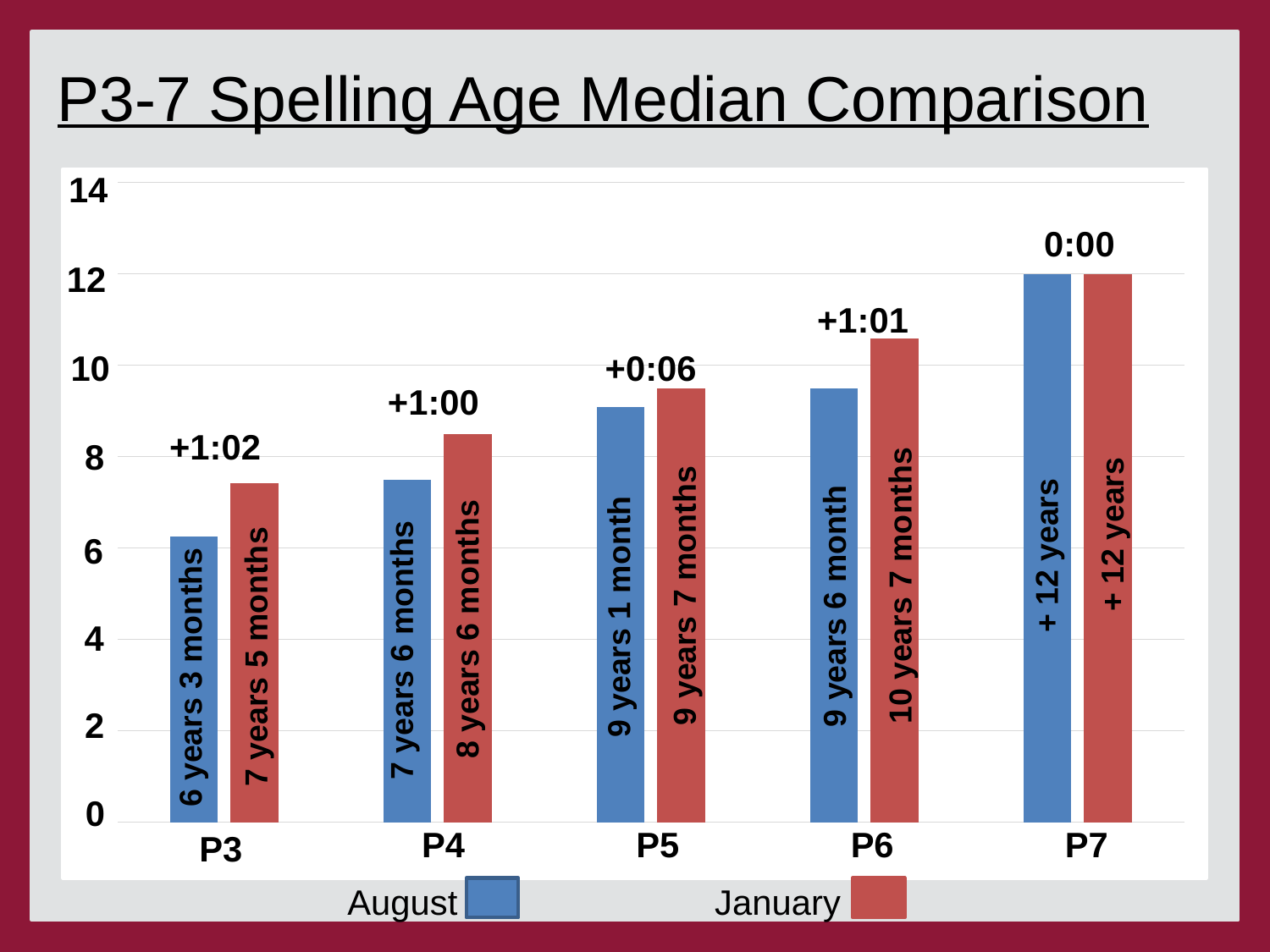
What is the August median spelling age for P3? 6 years 3 months Which year group has the lowest August median spelling age? P3 How many year-group categories are shown on the x axis? 5 Do the August median spelling ages rise or fall from P3 to P7? rise What kind of chart is shown on the slide? bar chart How many series does the legend list? 2 What change is printed above the P6 bars? +1:01 What is the January median spelling age for P6? 10 years 7 months What is the January median spelling age for P4? 8 years 6 months Is the January value for P6 greater or less than 10? greater What is the title of the chart on the slide? P3-7 Spelling Age Median Comparison What is the August median spelling age for P5? 9 years 1 month